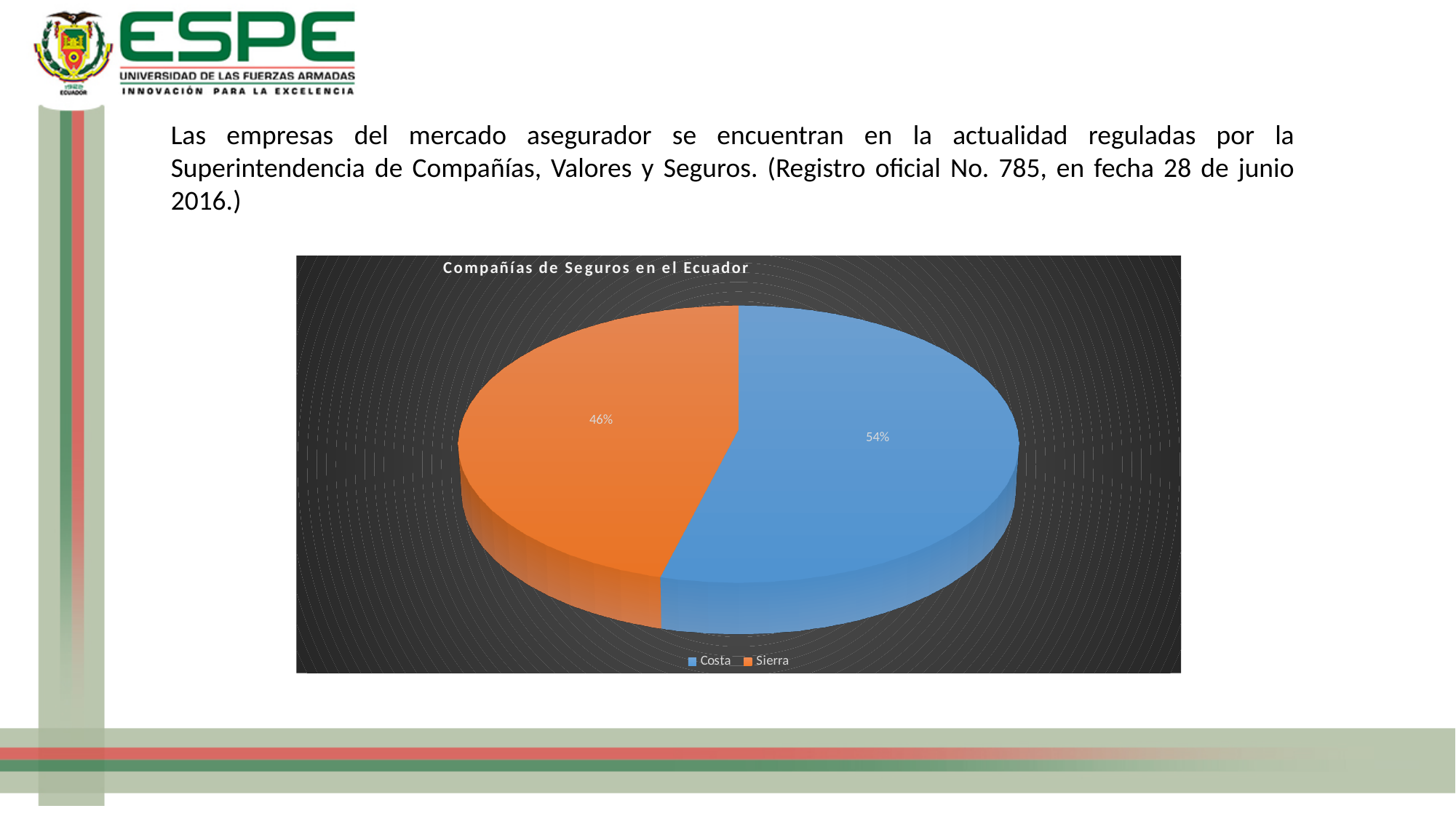
How many categories are shown in the pie chart? 2 What colour is the Sierra slice? Orange Which category has the smallest slice of the pie? Sierra Which slice is larger, Costa or Sierra? Costa What share of the pie does Costa represent? 54% What is the title of the chart? Compañías de Seguros en el Ecuador What share of the pie does Sierra represent? 46% What type of chart is shown on the slide? Pie chart What is the difference in percentage points between the Costa and Sierra slices? 8 How many entries does the legend list? 2 Which category has the largest slice of the pie? Costa